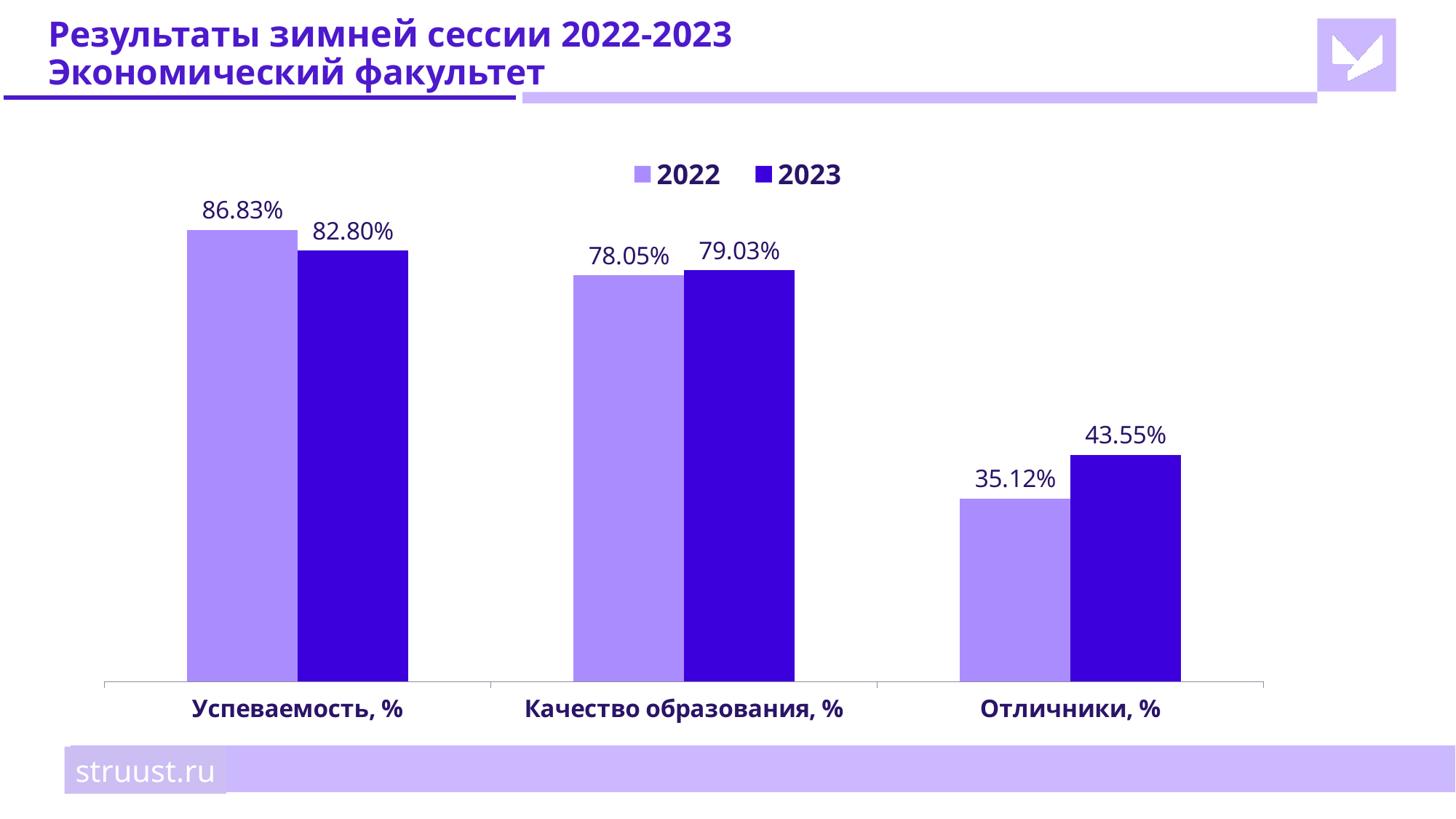
What is the value for 2023 in the Отличники, % category? 43.55% How many categories are shown on the x axis of the chart? 3 What is the value for 2023 in the Качество образования, % category? 79.03% Which category has the lowest value for the 2022 series? Отличники, % How many series does the chart legend list? 2 Which category has the highest value for the 2023 series? Успеваемость, % In the Успеваемость, % category, which series has the larger value, 2022 or 2023? 2022 What kind of chart is shown on the slide? Bar chart What is the difference between the 2022 and 2023 values in the Успеваемость, % category? 4.03% What is the value for 2022 in the Успеваемость, % category? 86.83% What is the difference between the 2022 and 2023 values in the Отличники, % category? 8.43% In the Качество образования, % category, which series has the larger value, 2022 or 2023? 2023